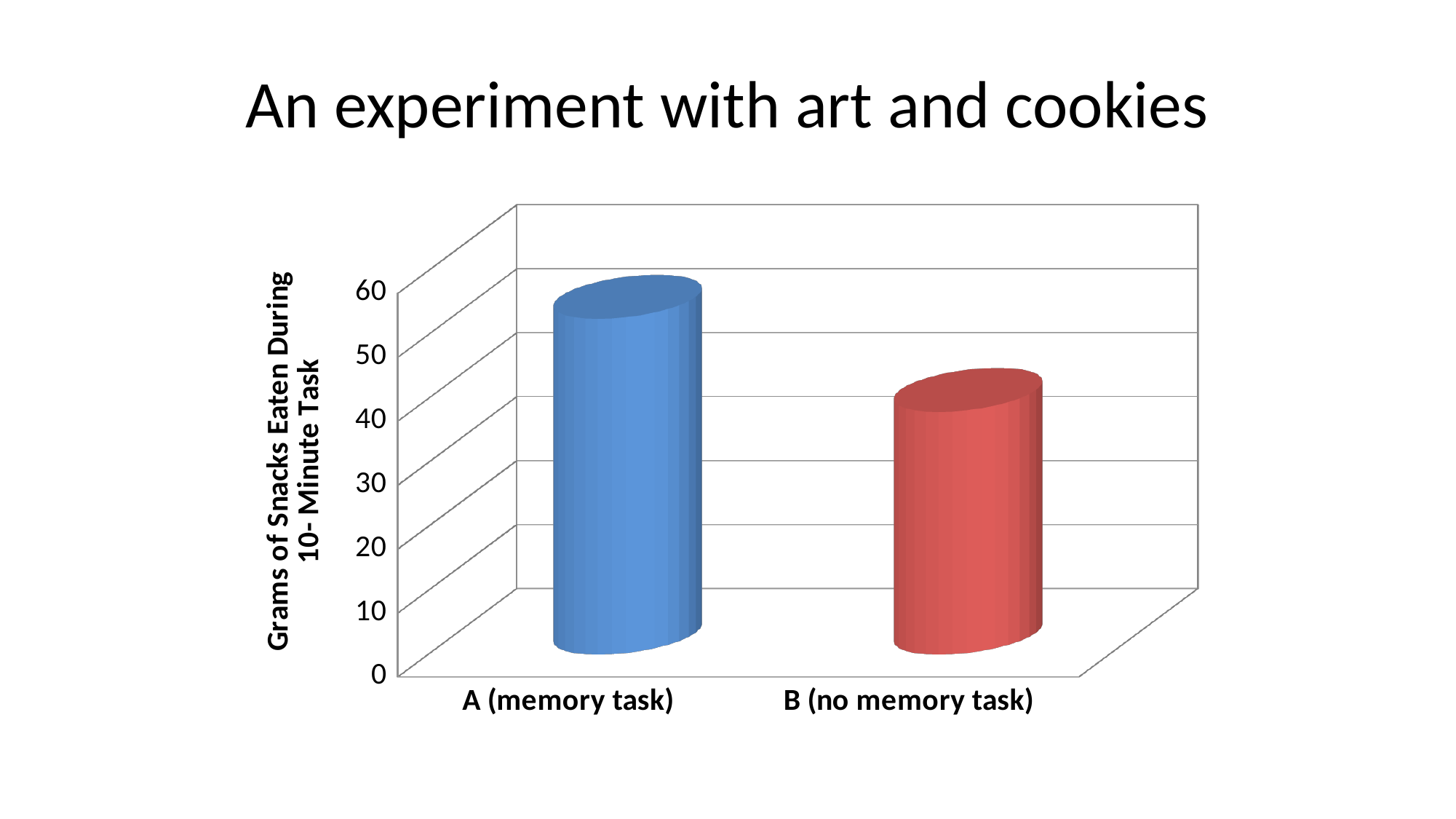
What is the label of the vertical axis? Grams of Snacks Eaten During 10- Minute Task Is the value for A (memory task) greater or less than 50? greater What kind of chart is shown on the slide? bar chart What is the title of the slide? An experiment with art and cookies Is the value for B (no memory task) greater or less than 50? less How many categories are plotted in the chart? 2 Which is larger, the value for A (memory task) or B (no memory task)? A (memory task) Which category has the lowest value? B (no memory task) Is the value for A (memory task) greater or less than 40? greater Which category has the highest value? A (memory task)